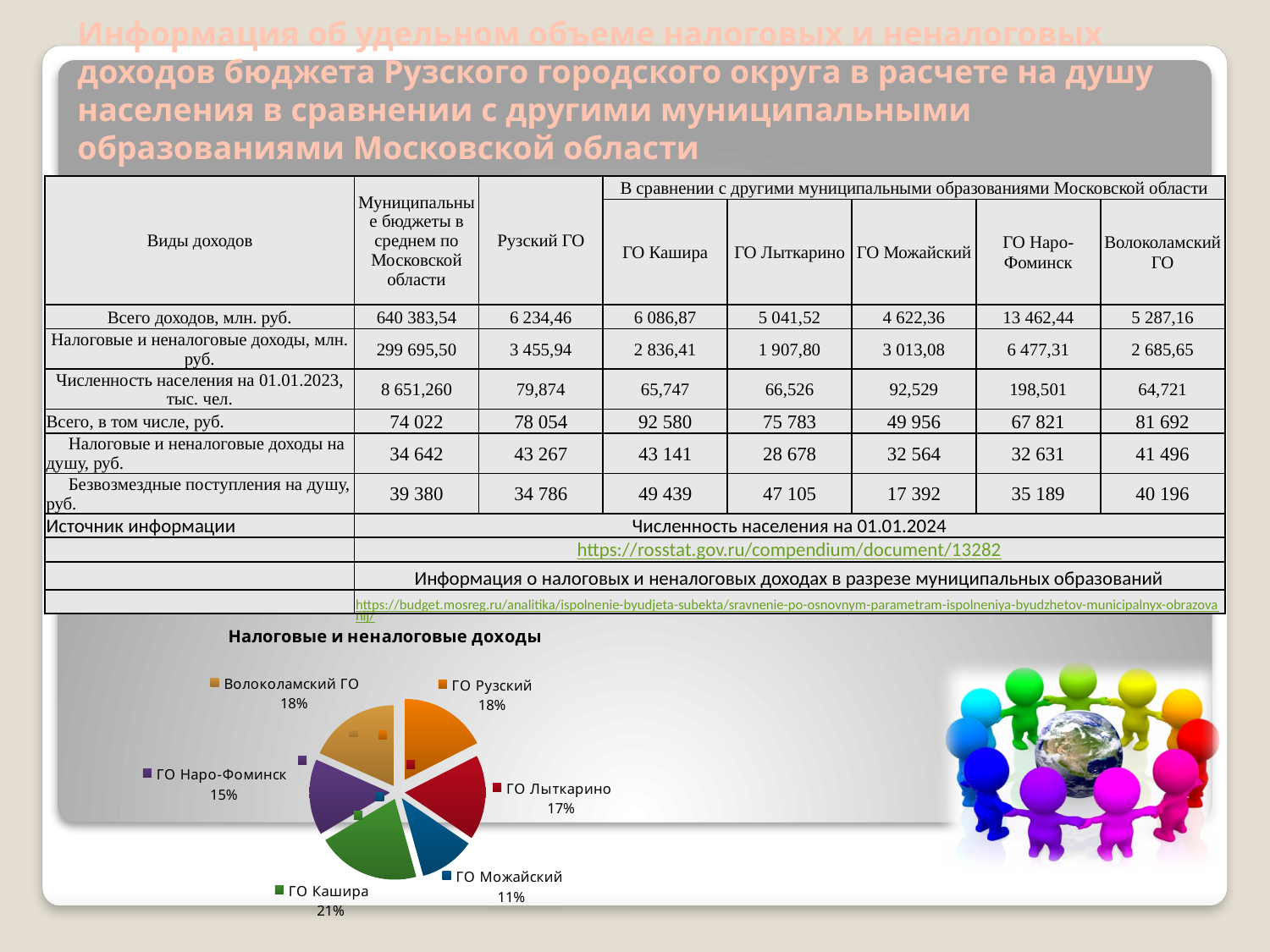
Which slice of the pie chart is the smallest? ГО Можайский What share of the pie does ГО Лыткарино have? 17% What share of the pie does ГО Наро-Фоминск have? 15% What kind of chart is shown on the slide? pie chart What share of the pie does ГО Можайский have? 11% How many slices does the pie chart have? 6 What is the title of the pie chart? Налоговые и неналоговые доходы What is the difference in percentage points between the shares of ГО Кашира and ГО Можайский? 10 Which has a larger share in the pie chart, ГО Наро-Фоминск or ГО Лыткарино? ГО Лыткарино Which slice of the pie chart is the largest? ГО Кашира